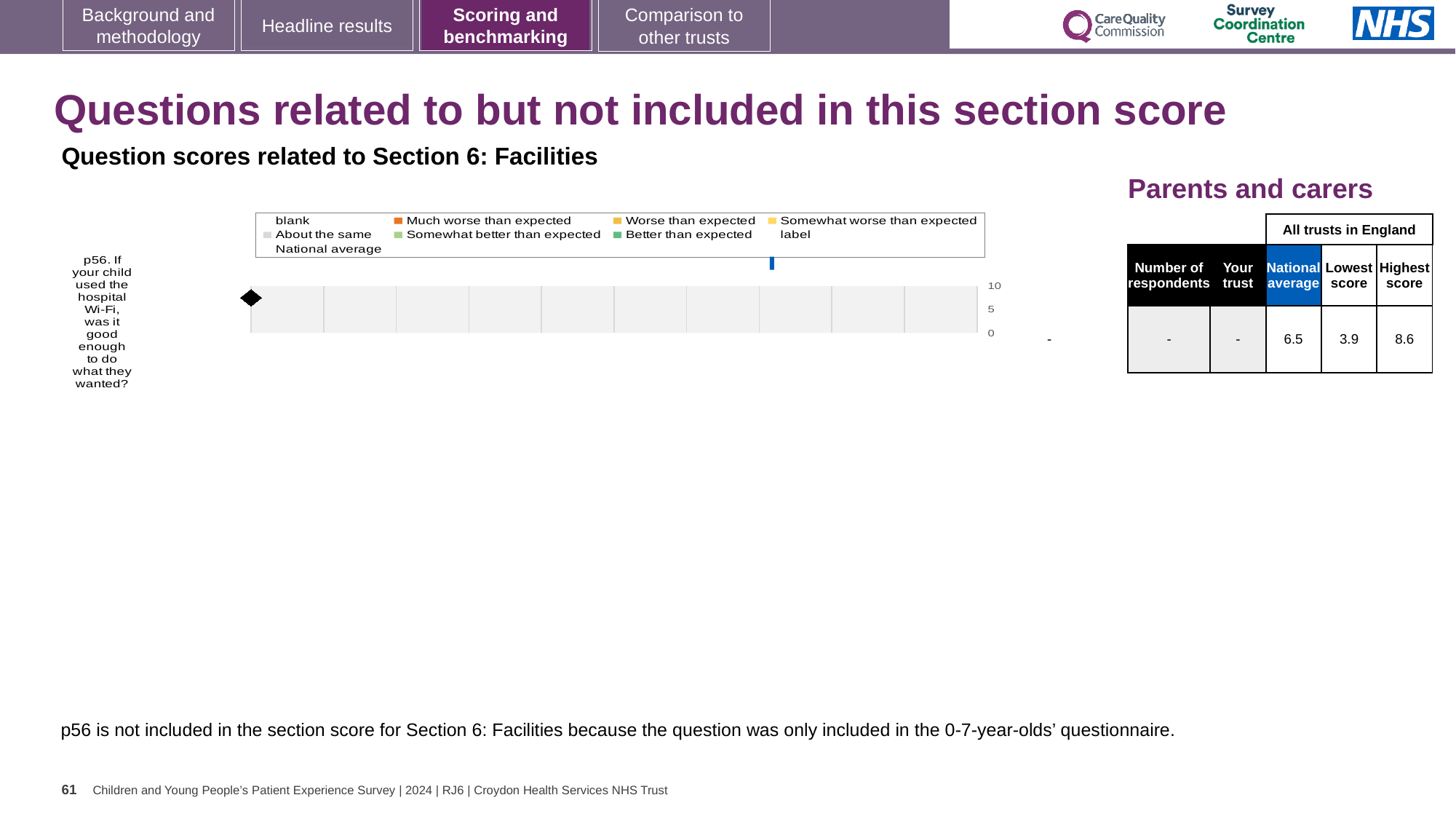
In the table next to the chart, what is the Highest score among all trusts in England for p56? 8.6 What is the highest value shown on the chart's value axis? 10 How many questions (categories) are plotted on the chart? 1 In the table next to the chart, what is the Lowest score among all trusts in England for p56? 3.9 What is the difference between the Highest score and the Lowest score shown in the table for p56? 4.7 In the table next to the chart, what is the National average score for p56? 6.5 Is the National average score for p56 greater or less than 5? greater What kind of chart is shown on the slide? bar chart Which is larger for p56: the National average or the Lowest score? National average What value is shown for 'Your trust' in the table for p56? - Which question is plotted on the chart? p56. If your child used the hospital Wi-Fi, was it good enough to do what they wanted?